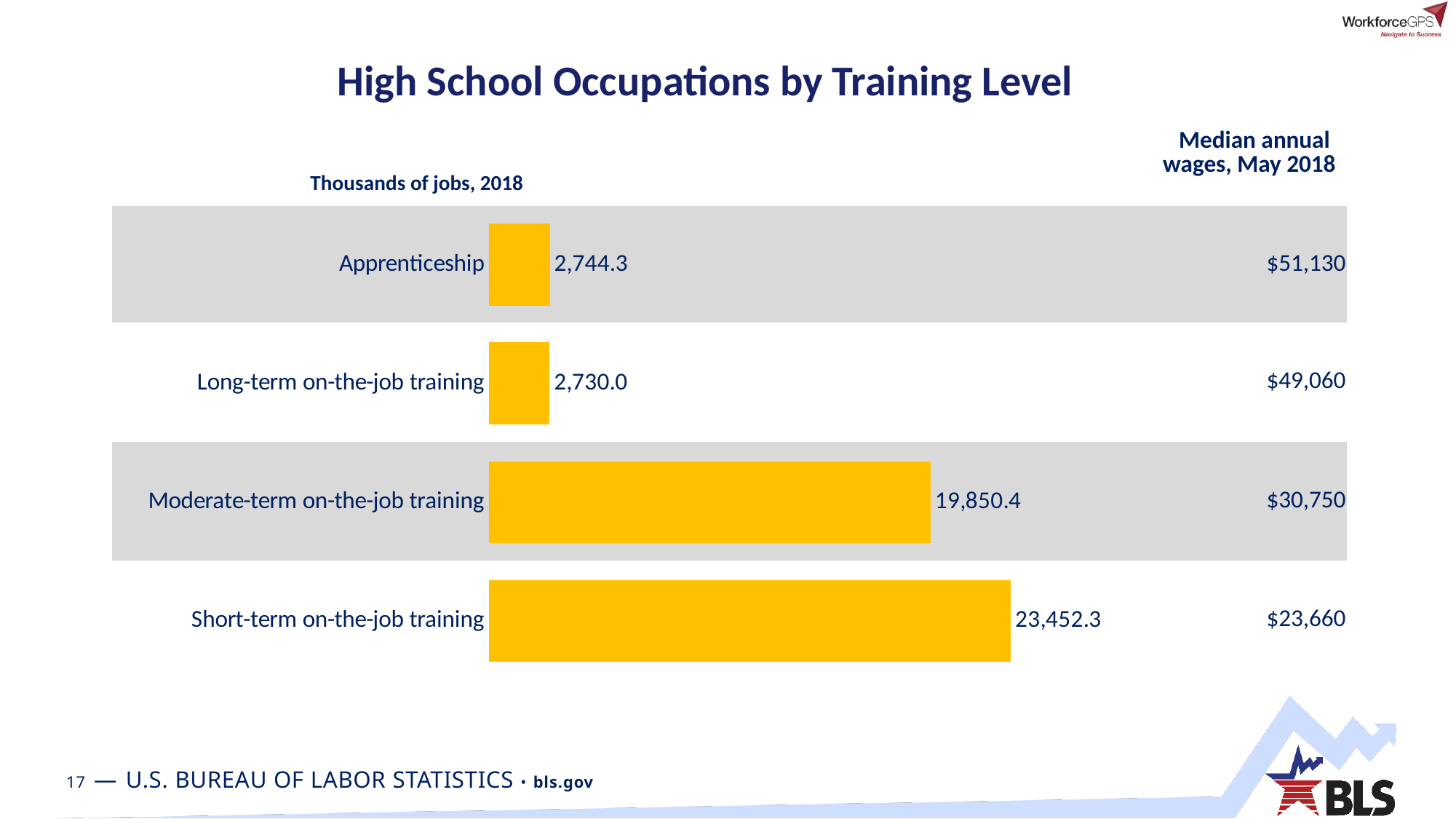
What is the median annual wage shown for Apprenticeship? $51,130 What is the difference in thousands of jobs between Short-term on-the-job training and Moderate-term on-the-job training? 3,601.9 What type of chart is shown on the slide? Bar chart What is the value for Short-term on-the-job training in thousands of jobs, 2018? 23,452.3 Which has more jobs, Apprenticeship or Moderate-term on-the-job training? Moderate-term on-the-job training Which training level has the lowest median annual wage? Short-term on-the-job training Which training level has the lowest number of jobs? Long-term on-the-job training What is the median annual wage shown for Moderate-term on-the-job training? $30,750 How many training levels are shown in the chart? 4 What is the difference in median annual wages between Apprenticeship and Long-term on-the-job training? $2,070 What is the value for Apprenticeship in thousands of jobs, 2018? 2,744.3 Which training level has the highest number of jobs? Short-term on-the-job training